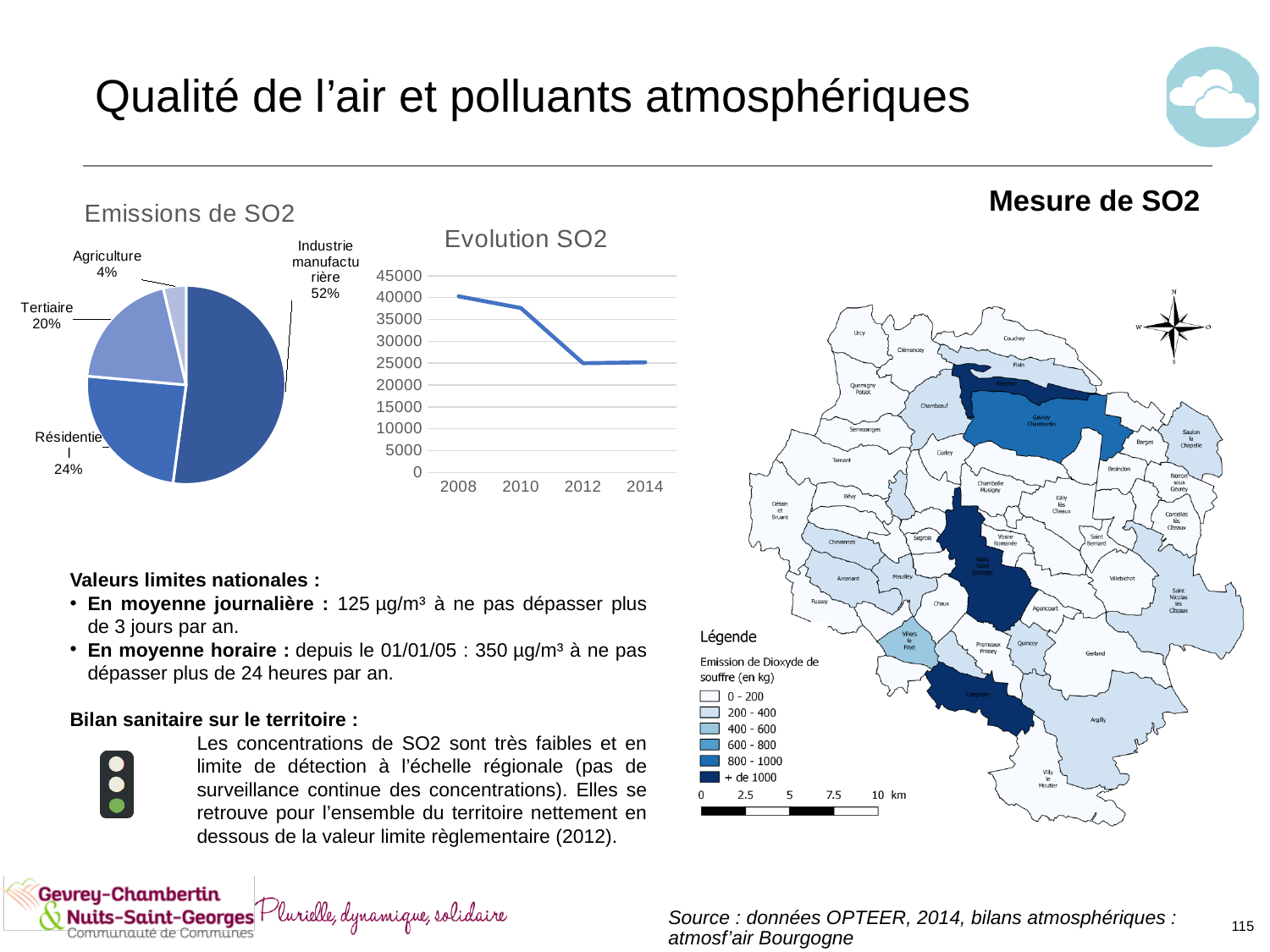
In the 'Emissions de SO2' pie chart, which is larger, Tertiaire or Résidentiel? Résidentiel In the 'Emissions de SO2' pie chart, which sector has the smallest share? Agriculture How many sectors are shown in the 'Emissions de SO2' pie chart? 4 In the 'Emissions de SO2' pie chart, what share of emissions comes from Agriculture? 4% In the 'Evolution SO2' chart, is the value for 2010 greater or less than 30000? greater In the 'Evolution SO2' chart, is the value for 2014 greater or less than 30000? less In the 'Emissions de SO2' pie chart, which sector has the largest share? Industrie manufacturière In the 'Emissions de SO2' pie chart, what share of emissions comes from Résidentiel? 24% In the 'Evolution SO2' chart, do the values rise or fall from 2008 to 2014? Fall What kind of chart is 'Evolution SO2'? Line chart In the 'Emissions de SO2' pie chart, what share of emissions comes from Industrie manufacturière? 52% In the 'Emissions de SO2' pie chart, what is the difference in percentage points between Résidentiel and Tertiaire? 4